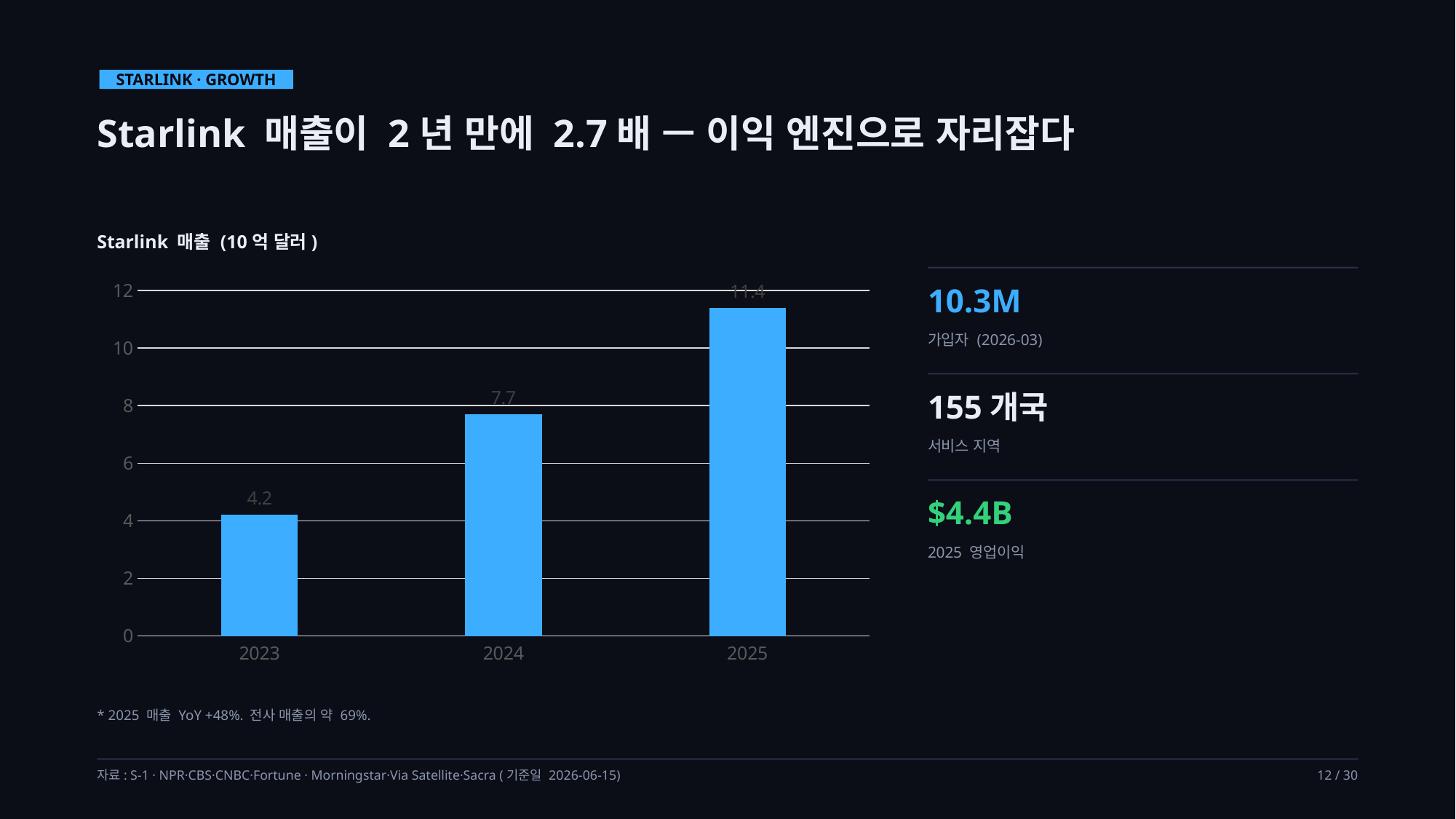
What kind of chart is used to show Starlink revenue? bar chart Do the Starlink revenue values rise or fall from 2023 to 2025? rise Which year has the lowest Starlink revenue in the chart? 2023 What is the Starlink revenue value shown for 2024? 7.7 How many years (bars) are shown in the chart? 3 What is the difference between the 2024 and 2023 Starlink revenue values? 3.5 What is the difference between the 2025 and 2024 Starlink revenue values? 3.7 What is the Starlink revenue value shown for 2025? 11.4 Is the Starlink revenue value for 2025 greater or less than 10? greater What is the Starlink revenue value shown for 2023? 4.2 Which is larger, the Starlink revenue for 2024 or for 2023? 2024 Which year has the highest Starlink revenue in the chart? 2025